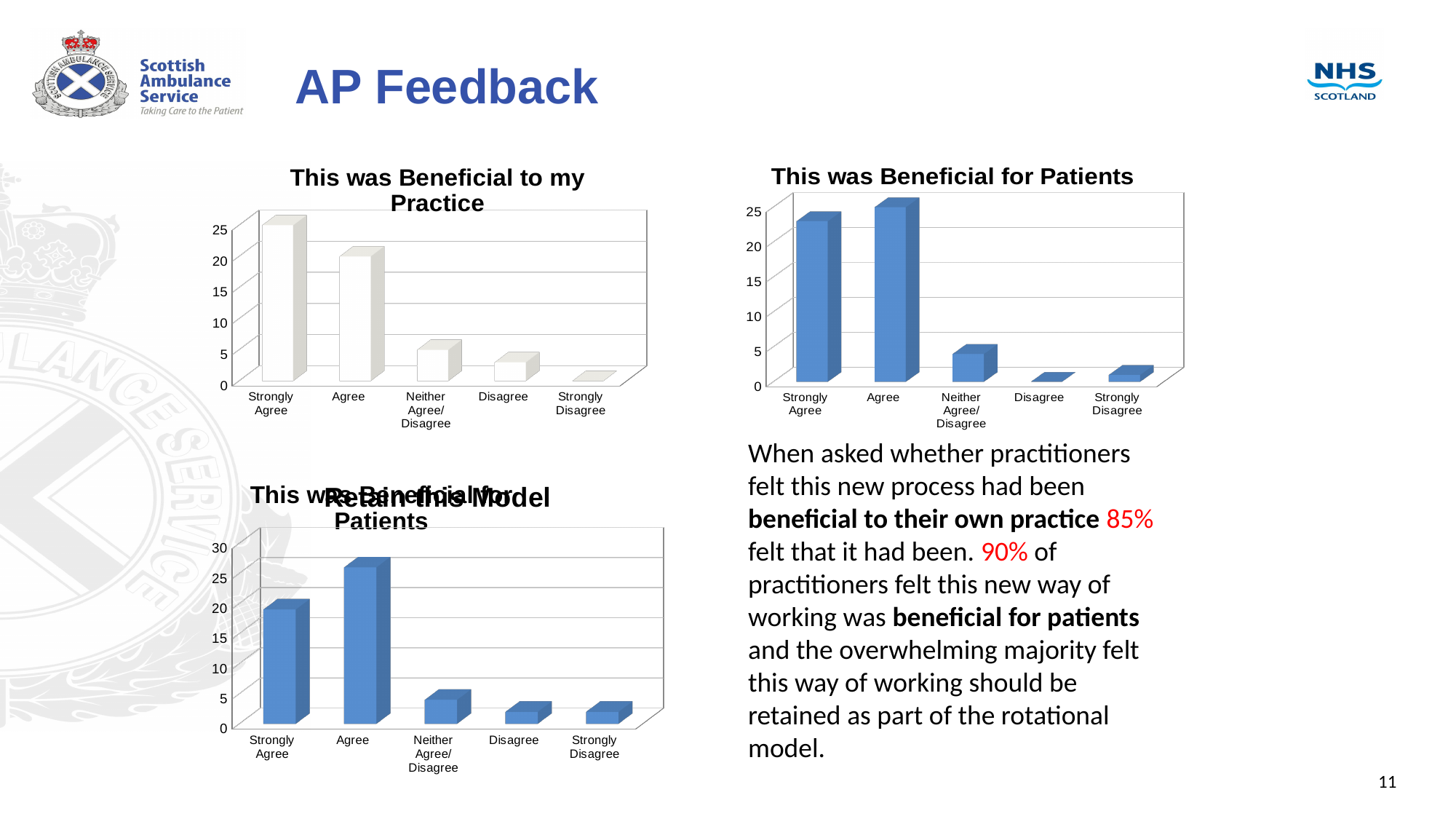
In the chart titled "This was Beneficial to my Practice", which category has the lowest value? Strongly Disagree In the bottom-left chart, which category has the highest value? Agree What kind of chart is the chart titled "This was Beneficial to my Practice"? bar chart In the chart titled "This was Beneficial for Patients", which category has the highest value? Agree In the chart titled "This was Beneficial to my Practice", which category has the highest value? Strongly Agree In the chart titled "This was Beneficial for Patients", which is larger, the value for Agree or the value for Neither Agree/Disagree? Agree In the chart titled "This was Beneficial for Patients", is the value for Strongly Agree greater or less than 20? greater How many categories are shown on the x axis of the chart titled "This was Beneficial for Patients"? 5 In the chart titled "This was Beneficial to my Practice", is the value for Neither Agree/Disagree greater or less than 10? less In the chart titled "This was Beneficial to my Practice", is the value for Agree greater or less than 15? greater